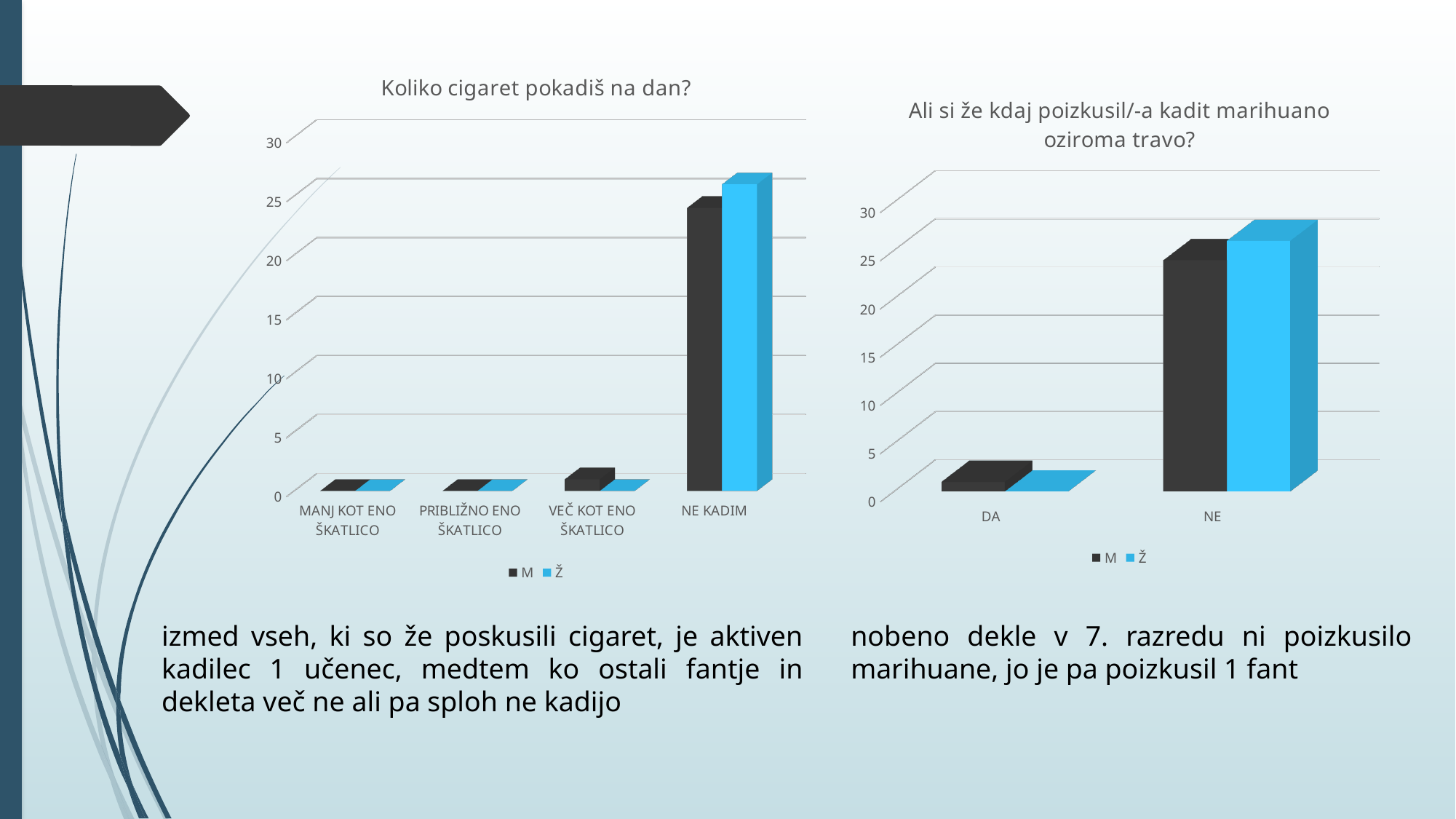
In the right chart "Ali si že kdaj poizkusil/-a kadit marihuano oziroma travo?", is the value for M in the NE category greater or less than 20? greater In the left chart "Koliko cigaret pokadiš na dan?", which series has the larger value in the NE KADIM category, M or Ž? Ž How many series does the legend of the left chart "Koliko cigaret pokadiš na dan?" list? 2 In the right chart "Ali si že kdaj poizkusil/-a kadit marihuano oziroma travo?", which category has the higher value for series Ž, DA or NE? NE What are the two legend entries of the right chart "Ali si že kdaj poizkusil/-a kadit marihuano oziroma travo?"? M and Ž In the left chart "Koliko cigaret pokadiš na dan?", which category has the highest value for series M? NE KADIM In the left chart "Koliko cigaret pokadiš na dan?", is the value for Ž in the NE KADIM category greater or less than 20? greater How many categories are shown on the x axis of the left chart "Koliko cigaret pokadiš na dan?"? 4 How many categories are shown on the x axis of the right chart "Ali si že kdaj poizkusil/-a kadit marihuano oziroma travo?"? 2 In the left chart "Koliko cigaret pokadiš na dan?", is the value for M in the VEČ KOT ENO ŠKATLICO category greater or less than 5? less What kind of chart is the left chart titled "Koliko cigaret pokadiš na dan?"? bar chart